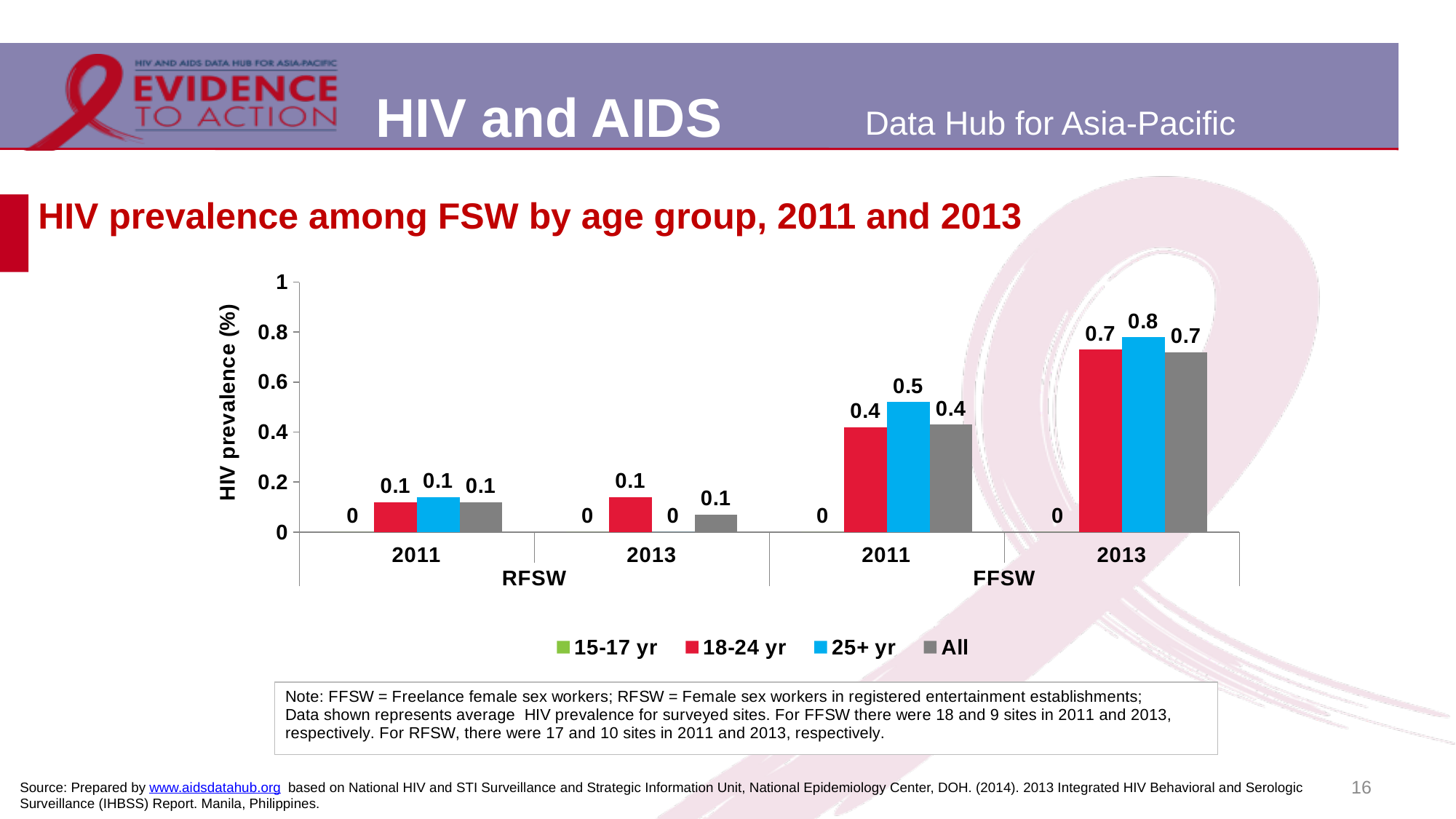
What is the HIV prevalence for the All group among RFSW in 2013? 0.1 Which bar shows the highest HIV prevalence on the chart? 25+ yr, FFSW 2013 What is the title of the vertical axis? HIV prevalence (%) For the 18-24 yr group among FFSW, which year has the higher HIV prevalence, 2011 or 2013? 2013 What is the HIV prevalence for the 25+ yr group among FFSW in 2013? 0.8 What is the HIV prevalence for the 25+ yr group among RFSW in 2013? 0 What is the HIV prevalence for the 18-24 yr group among FFSW in 2011? 0.4 What is the difference in HIV prevalence for the 25+ yr group among FFSW between 2013 and 2011? 0.3 How many year groups (category clusters) are shown along the x axis? 4 Did the HIV prevalence for the All group among FFSW rise or fall from 2011 to 2013? Rise What kind of chart is shown on the slide? Bar chart How many series does the legend list? 4